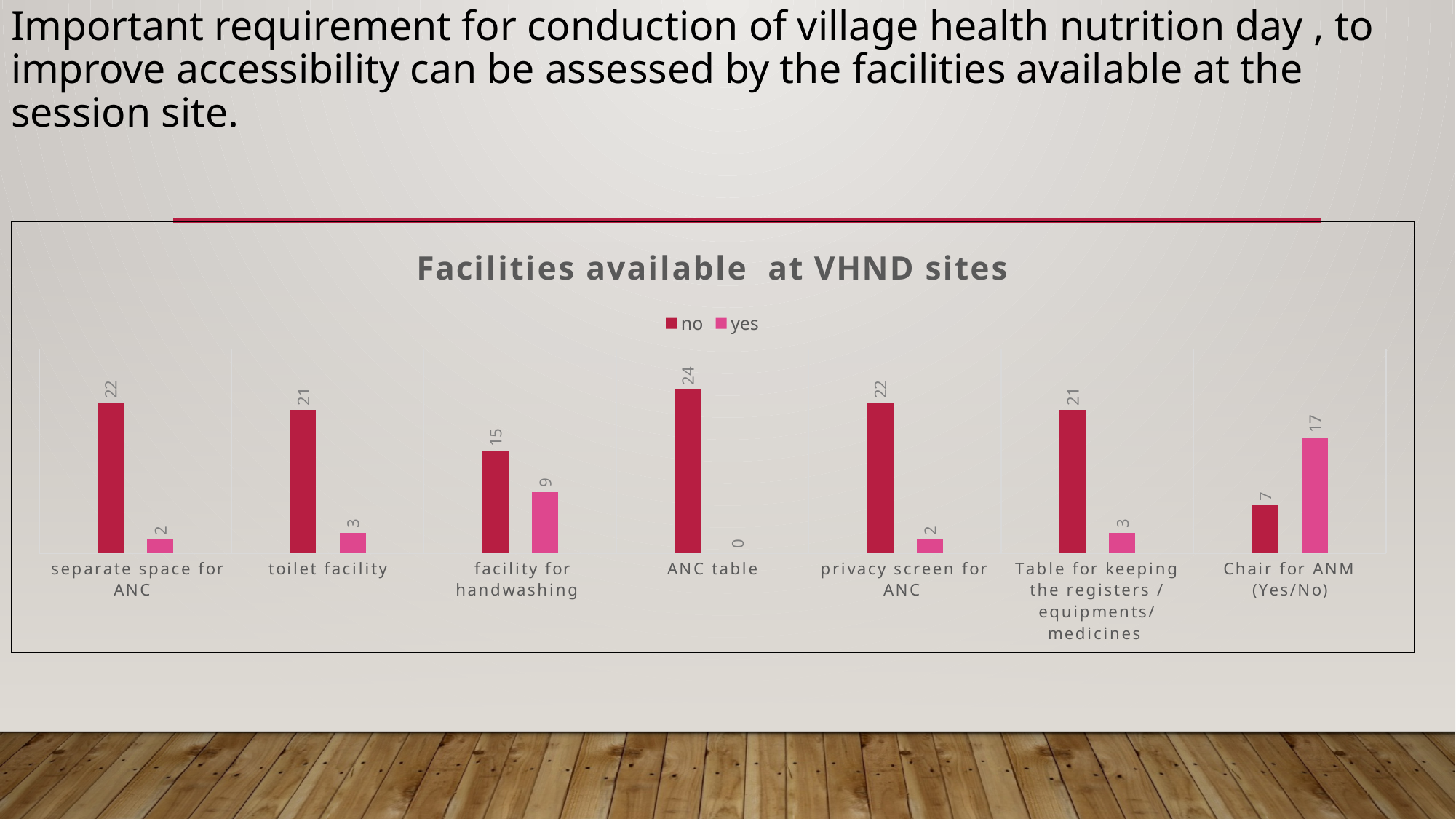
Which category has the lowest 'yes' value? ANC table How many series does the legend list? 2 How many categories are shown on the x axis? 7 What is the 'no' value for ANC table? 24 What is the 'yes' value for Chair for ANM (Yes/No)? 17 Which is larger for Chair for ANM (Yes/No): the 'no' value or the 'yes' value? yes What is the 'yes' value for facility for handwashing? 9 What is the 'no' value for privacy screen for ANC? 22 What is the title of the chart? Facilities available at VHND sites What kind of chart is shown? bar chart Which category has the highest 'no' value? ANC table What is the difference between the 'no' and 'yes' values for toilet facility? 18